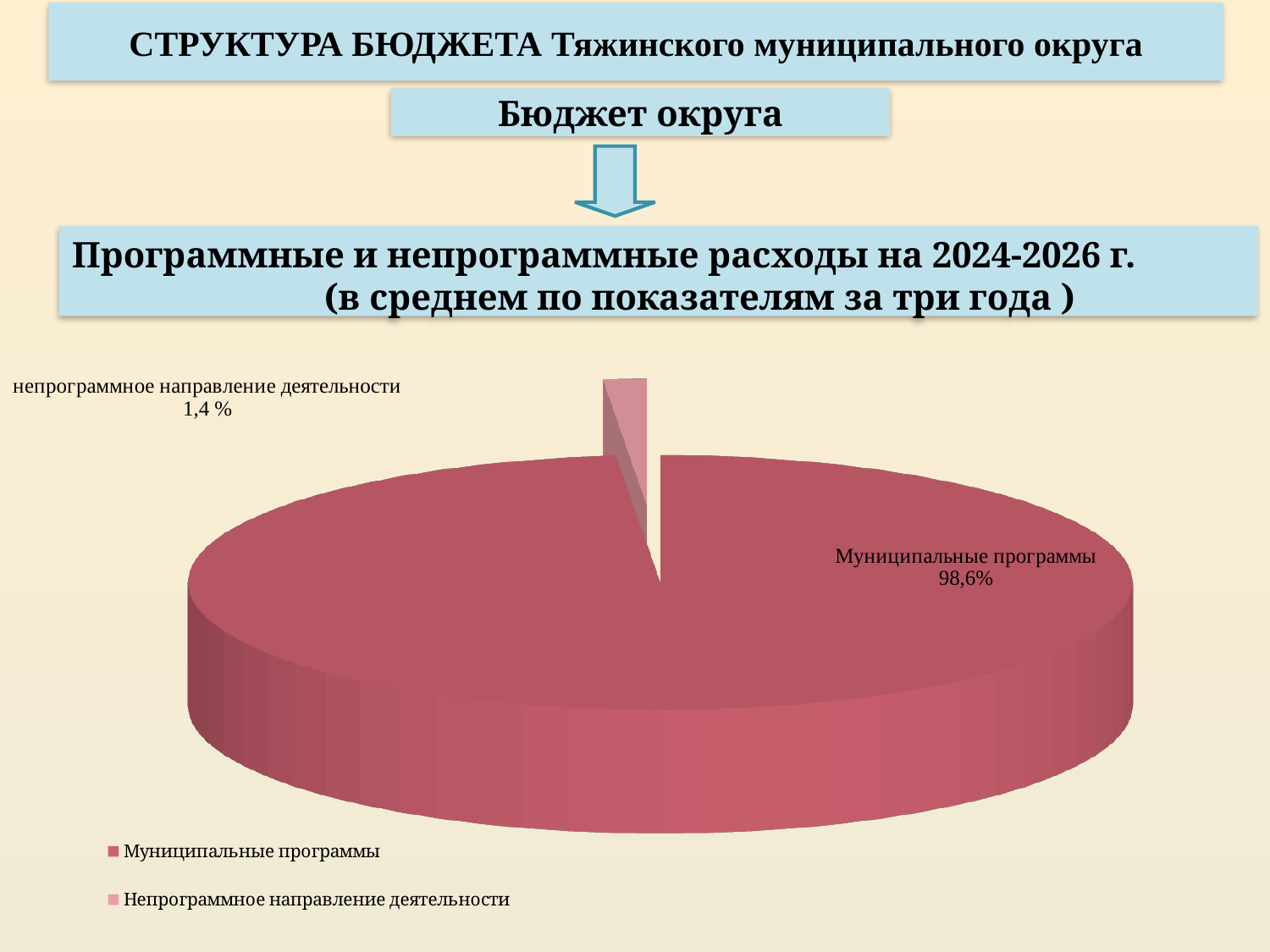
Which slice of the pie is the smallest? Непрограммное направление деятельности How many slices does the pie chart have? 2 What period does the chart heading say the programme and non-programme expenditures cover? 2024-2026 г. What share of the pie is labelled for Муниципальные программы? 98,6% What is the difference in percentage points between the Муниципальные программы slice and the непрограммное направление деятельности slice? 97,2 What share of the pie is labelled for непрограммное направление деятельности? 1,4 % How many entries does the legend list? 2 Which legend entry is shown in the lighter pink colour? Непрограммное направление деятельности Which slice of the pie is the largest? Муниципальные программы What kind of chart is shown on the slide? Pie chart Which is larger: the share for Муниципальные программы or the share for непрограммное направление деятельности? Муниципальные программы